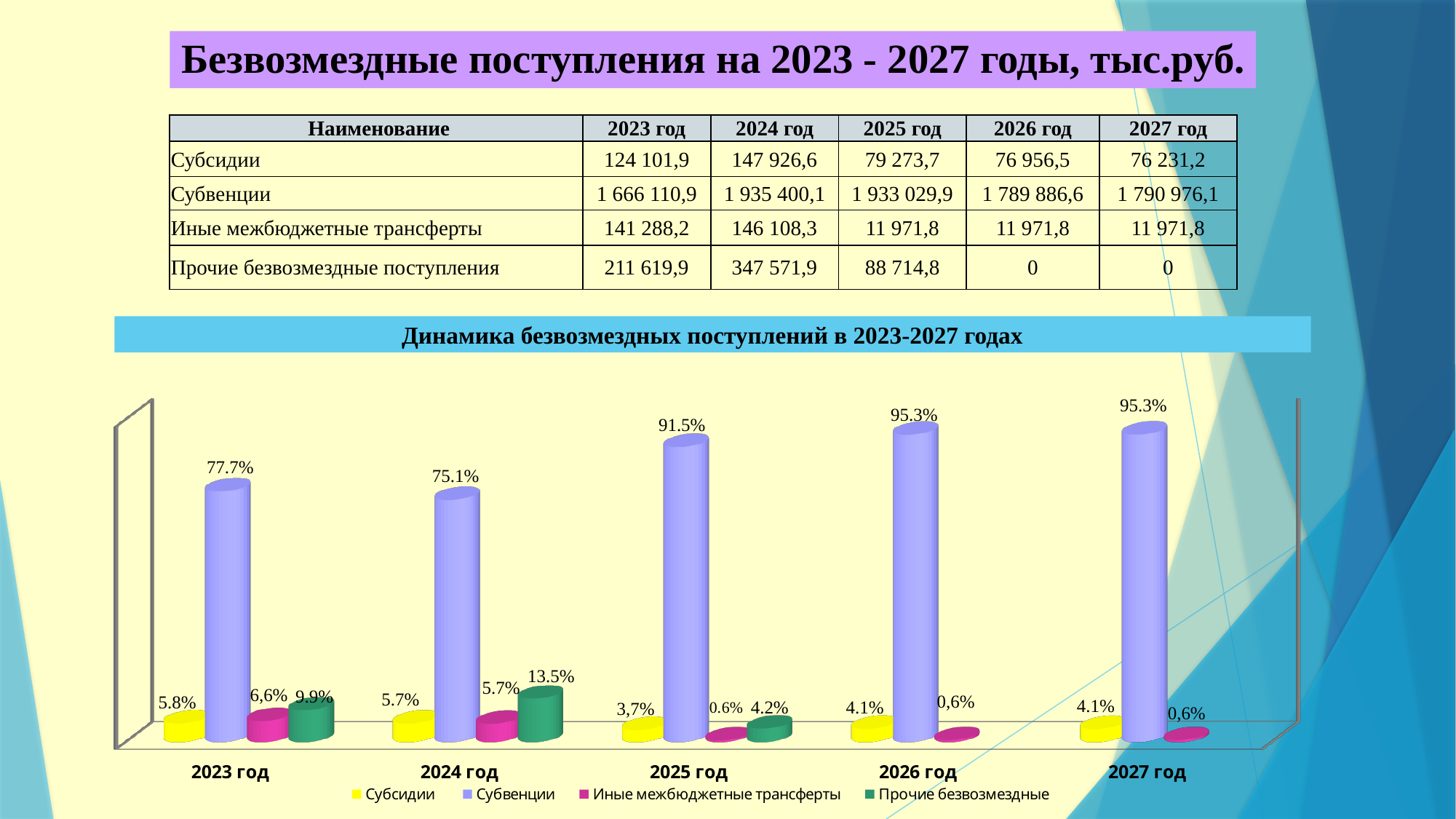
In which year is the Прочие безвозмездные value highest on the chart? 2024 год What is the value for Иные межбюджетные трансферты in 2027 год on the chart? 0,6% What is the difference between the Субвенции values for 2025 год and 2024 год on the chart? 16.4% Which is larger on the chart: Субсидии in 2023 год or Субсидии in 2026 год? Субсидии in 2023 год What is the value for Субсидии in 2025 год on the chart? 3,7% Which colour represents Субвенции in the chart legend? light purple What kind of chart is shown under the heading 'Динамика безвозмездных поступлений в 2023-2027 годах'? bar chart In which year is the Субвенции value lowest on the chart? 2024 год How many series does the chart legend list? 4 What is the value for Прочие безвозмездные in 2024 год on the chart? 13.5% What is the value for Субвенции in 2023 год on the chart? 77.7% How many year categories are shown on the x axis of the chart? 5